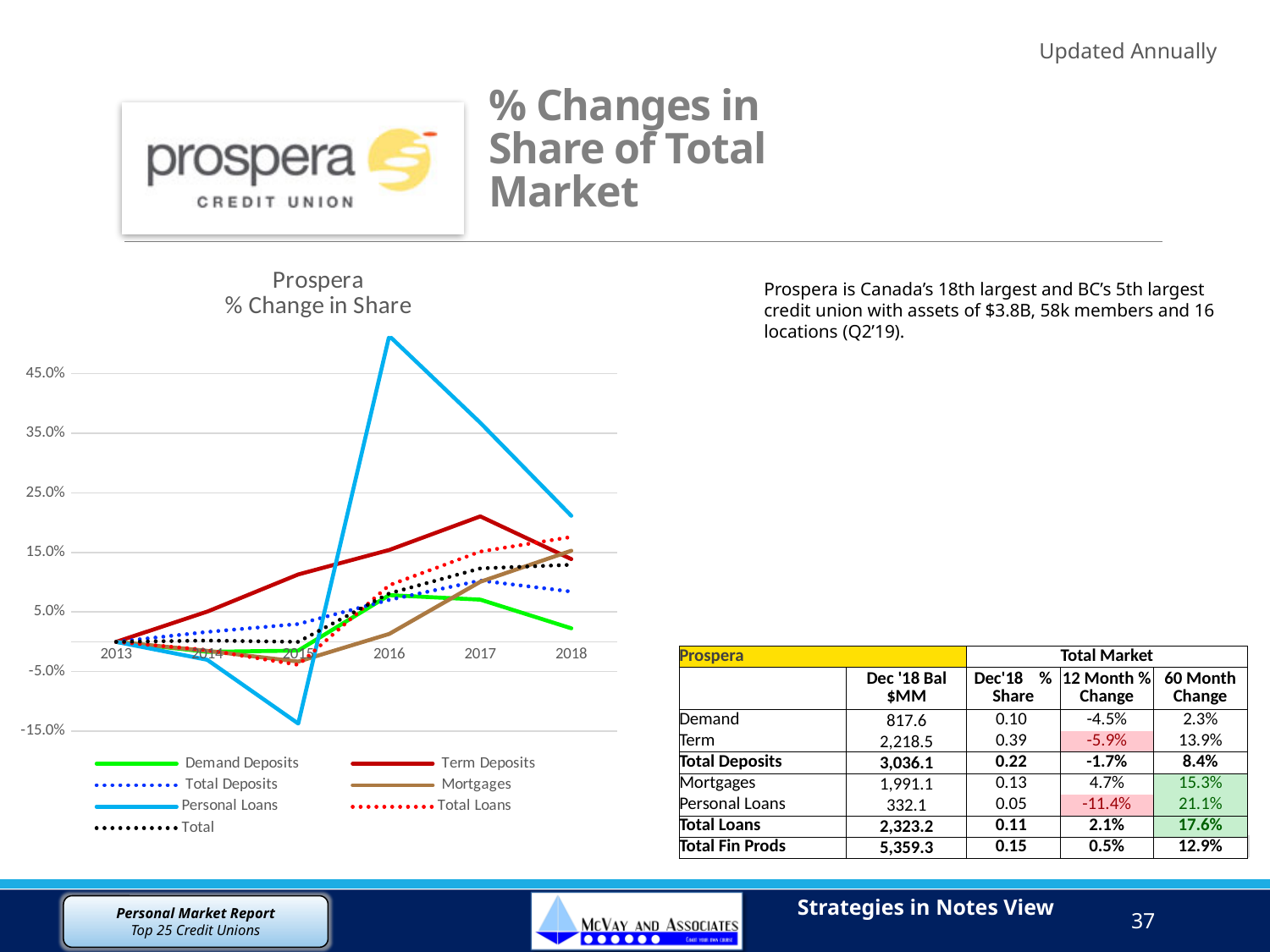
In 2017, which is larger: Term Deposits or Demand Deposits? Term Deposits How many years are plotted along the x axis of the chart? 6 How many series does the chart legend list? 7 What kind of chart is shown on the slide? Line chart Is the value for Demand Deposits in 2018 greater or less than 5.0%? less What is the title of the chart? Prospera % Change in Share Does the Personal Loans line rise or fall from 2016 to 2018? Fall Is the value for Personal Loans in 2015 greater or less than -5.0%? less Which series has the highest value in 2016? Personal Loans Which series has the lowest value in 2015? Personal Loans Is the value for Personal Loans in 2016 greater or less than 45.0%? greater